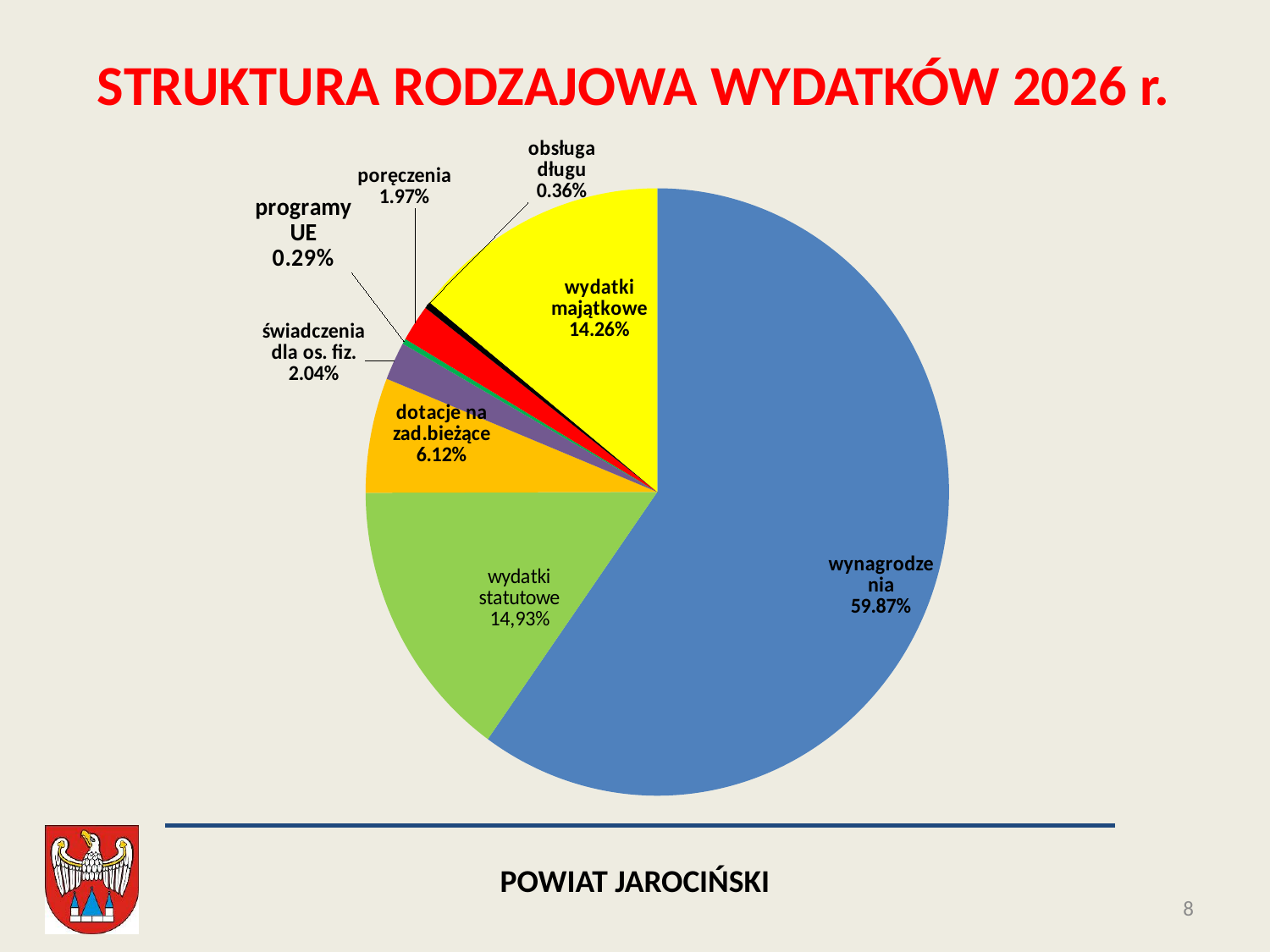
What is the value shown for obsługa długu? 0.36% Which is larger, the share for świadczenia dla os. fiz. or the share for poręczenia? świadczenia dla os. fiz. What is the difference between the shares of wynagrodzenia and wydatki majątkowe? 45.61% What kind of chart is shown on the slide? pie chart What is the value shown for wydatki majątkowe? 14.26% What share of the pie does wynagrodzenia have? 59.87% What is the title of the slide containing the chart? STRUKTURA RODZAJOWA WYDATKÓW 2026 r. What is the value shown for wydatki statutowe? 14,93% Which category has the smallest slice of the pie? programy UE How many slices does the pie chart have? 8 What is the value shown for dotacje na zad.bieżące? 6.12% Which category has the largest slice of the pie? wynagrodzenia